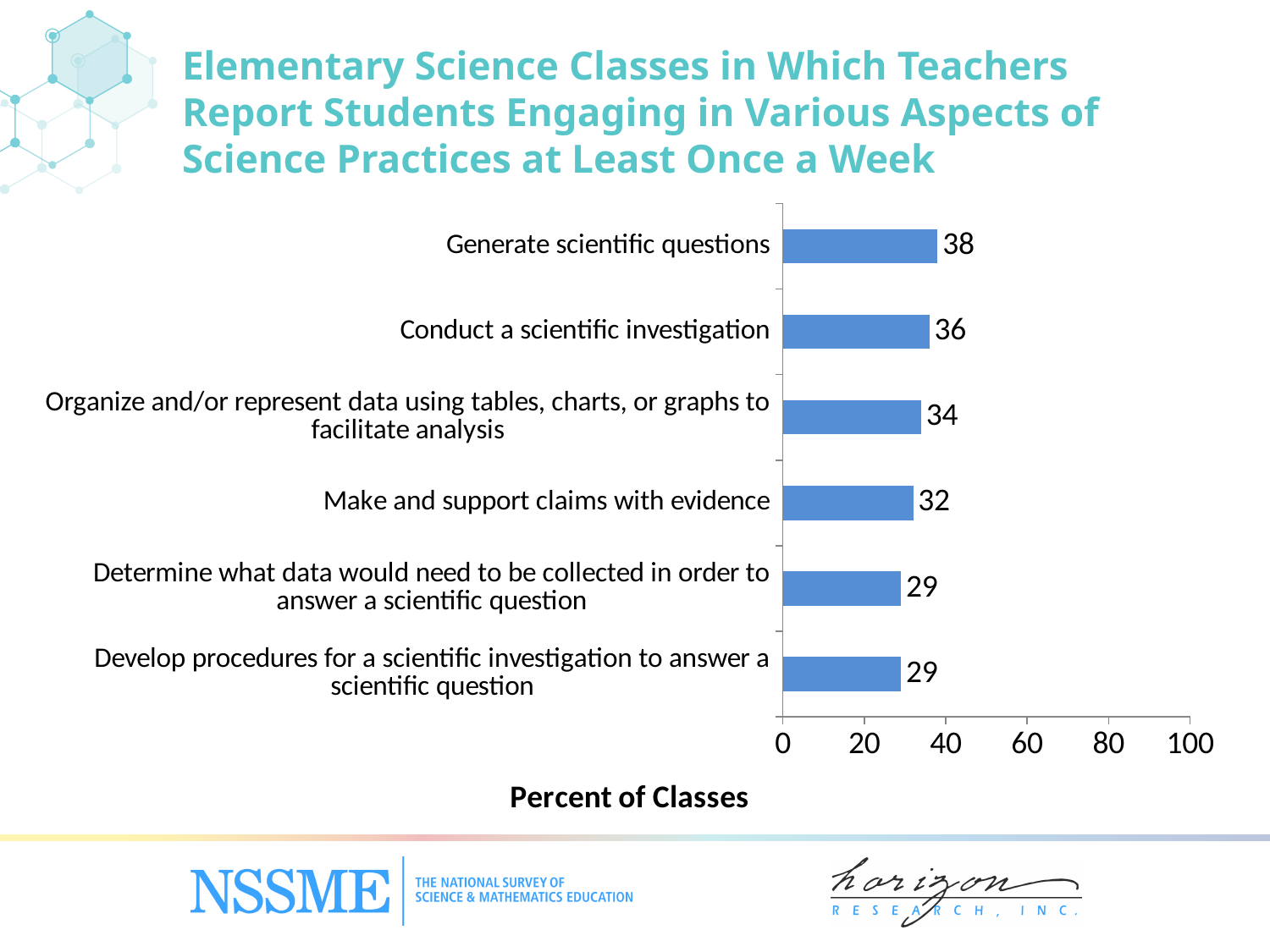
What is the lowest value shown on the chart? 29 How many categories are shown on the chart? 6 Which is larger: the value for "Conduct a scientific investigation" or the value for "Determine what data would need to be collected in order to answer a scientific question"? Conduct a scientific investigation Is the value for "Generate scientific questions" greater or less than 40? less Which category has the highest value? Generate scientific questions What kind of chart is shown on the slide? Bar chart What is the value for "Make and support claims with evidence"? 32 What is the difference between the values for "Generate scientific questions" and "Make and support claims with evidence"? 6 What is the value for "Organize and/or represent data using tables, charts, or graphs to facilitate analysis"? 34 What is the value for "Conduct a scientific investigation"? 36 What percent of classes is reported for "Generate scientific questions"? 38 What is the label of the horizontal axis? Percent of Classes